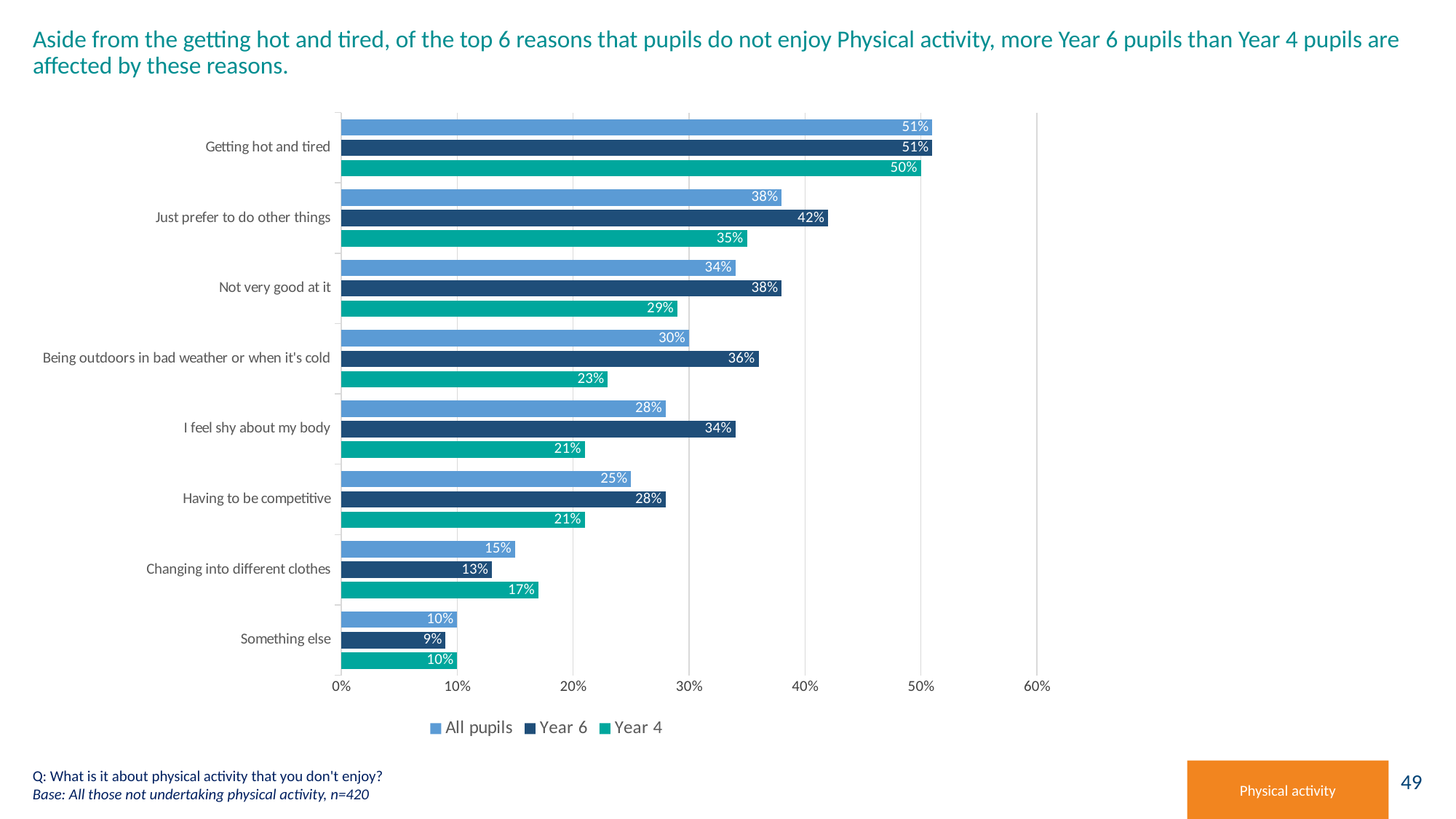
What is the Year 6 value for "Just prefer to do other things"? 42% What is the difference between the Year 6 and Year 4 values for "I feel shy about my body"? 13% What is the Year 4 value for "Being outdoors in bad weather or when it's cold"? 23% What kind of chart is shown on the slide? Bar chart What are the three series listed in the legend? All pupils, Year 6, Year 4 Which is larger for "Changing into different clothes": the Year 6 value or the Year 4 value? Year 4 How many series does the legend list? 3 Is the Year 6 value for "Not very good at it" greater or less than 30%? greater Which category has the lowest All pupils value? Something else What is the All pupils value for "I feel shy about my body"? 28% How many categories are shown on the chart? 8 Which category has the highest Year 6 value? Getting hot and tired